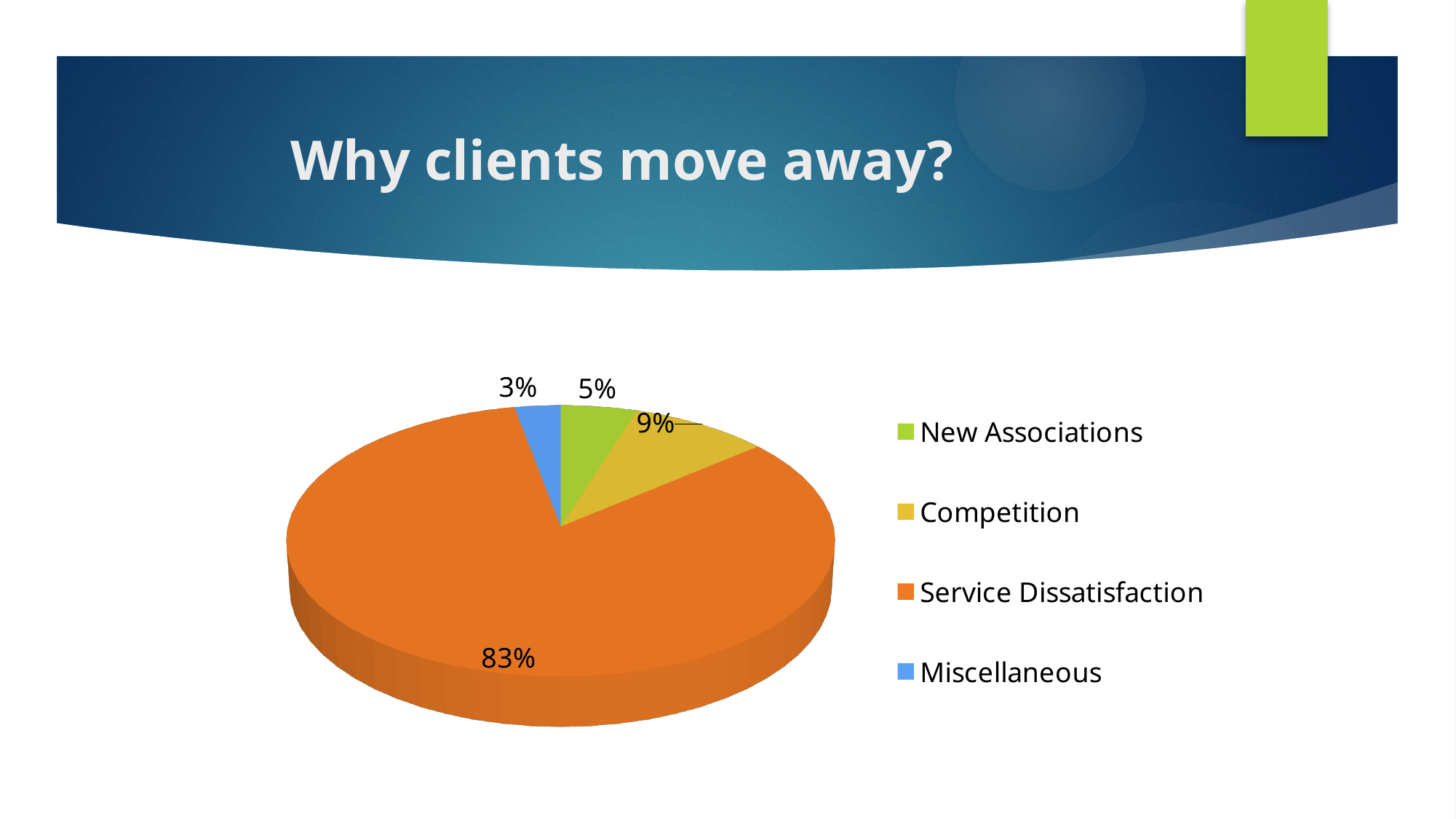
Which category has the smallest slice of the pie? Miscellaneous What percentage is shown for Competition? 9% How many categories does the pie chart show? 4 What share of the pie does Service Dissatisfaction account for? 83% Which category has the largest slice of the pie? Service Dissatisfaction Which is larger, the share for Competition or the share for New Associations? Competition What colour is the slice for Miscellaneous? Blue What percentage is shown for New Associations? 5% What percentage is shown for Miscellaneous? 3% What kind of chart is shown on the slide? Pie chart What is the difference in percentage points between Service Dissatisfaction and Competition? 74 What is the title of the slide containing the chart? Why clients move away?